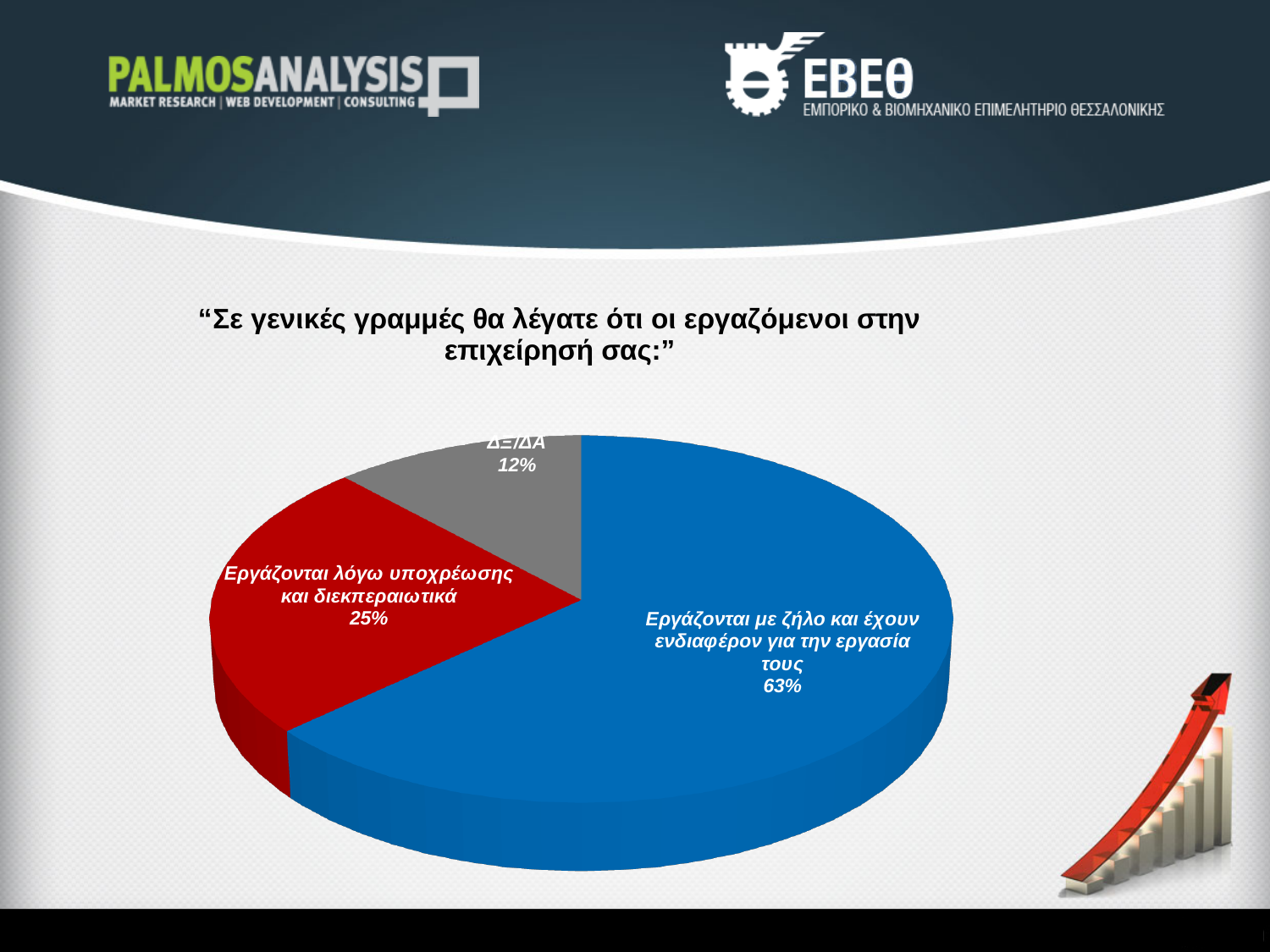
Which slice of the pie is the smallest? ΔΞ/ΔΑ How many slices does the pie chart have? 3 Which slice of the pie is the largest? Εργάζονται με ζήλο και έχουν ενδιαφέρον για την εργασία τους What percentage is shown for the ΔΞ/ΔΑ slice? 12% What share of respondents said employees "Εργάζονται με ζήλο και έχουν ενδιαφέρον για την εργασία τους"? 63% What kind of chart is shown on the slide? Pie chart What colour is the slice for "Εργάζονται με ζήλο και έχουν ενδιαφέρον για την εργασία τους"? Blue What is the difference in percentage points between the "Εργάζονται με ζήλο" slice and the "Εργάζονται λόγω υποχρέωσης" slice? 38 percentage points What colour is the ΔΞ/ΔΑ slice? Grey What is the difference in percentage points between the "Εργάζονται λόγω υποχρέωσης και διεκπεραιωτικά" slice and the ΔΞ/ΔΑ slice? 13 percentage points Which is larger: the "Εργάζονται λόγω υποχρέωσης και διεκπεραιωτικά" slice or the ΔΞ/ΔΑ slice? Εργάζονται λόγω υποχρέωσης και διεκπεραιωτικά What share of respondents said employees "Εργάζονται λόγω υποχρέωσης και διεκπεραιωτικά"? 25%